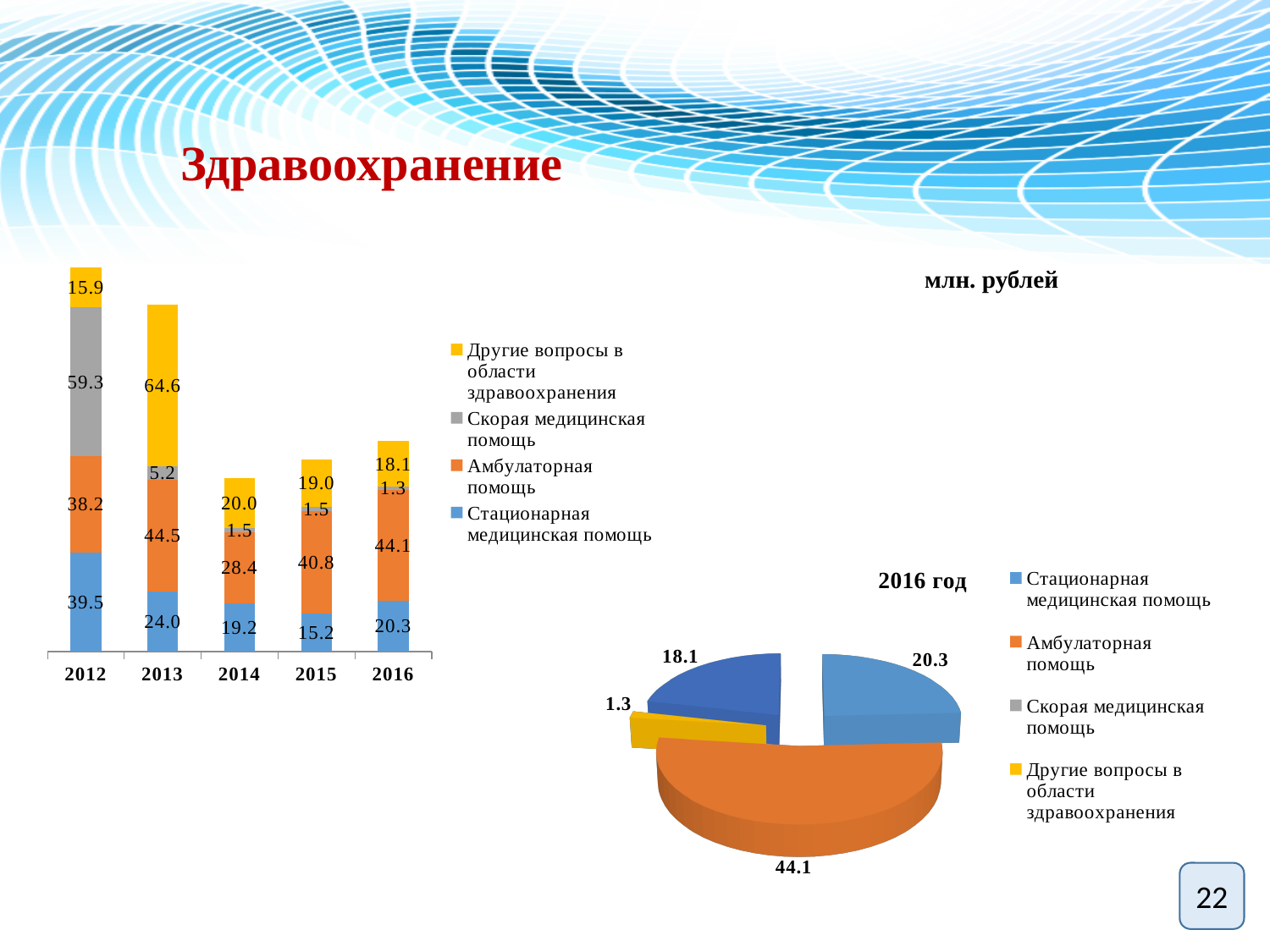
On the stacked bar chart, in which year is the value for Стационарная медицинская помощь lowest? 2015 On the stacked bar chart, in which year is the value for Скорая медицинская помощь highest? 2012 On the stacked bar chart, what is the difference between Амбулаторная помощь in 2016 and in 2014? 15.7 On the 2016 год pie chart, which category has the smallest slice? Другие вопросы в области здравоохранения On the stacked bar chart, how many series does the legend list? 4 On the stacked bar chart, what is the value for Амбулаторная помощь in 2015? 40.8 On the stacked bar chart, how many years are shown on the x axis? 5 On the stacked bar chart, what is the value for Другие вопросы в области здравоохранения in 2013? 64.6 On the stacked bar chart, what is the total of the 2014 bar? 69.1 On the 2016 год pie chart, what is the value for Амбулаторная помощь? 44.1 What type of chart is the chart on the left of the slide? Stacked bar chart On the stacked bar chart, what is the value for Стационарная медицинская помощь in 2012? 39.5